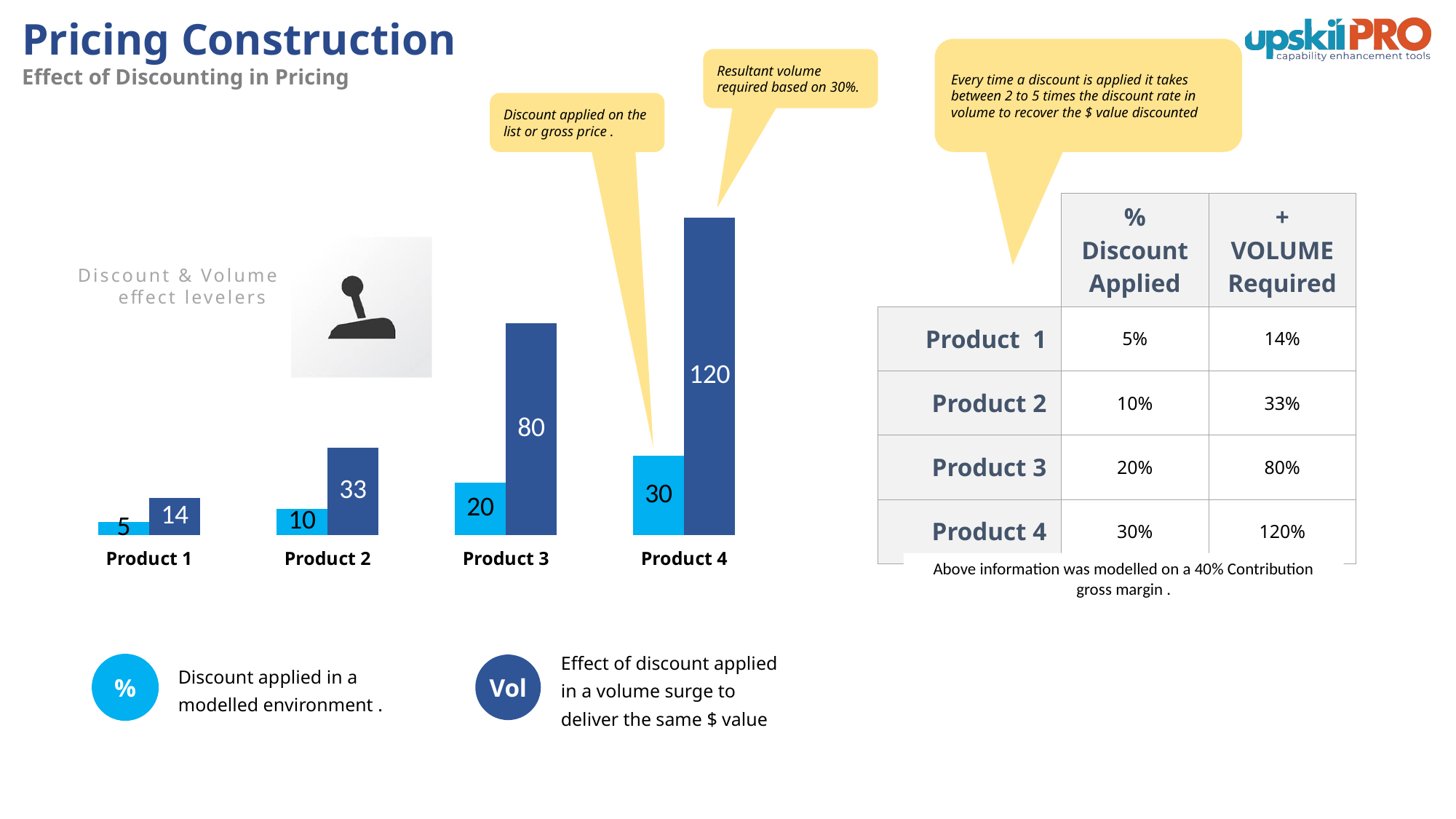
What colour are the discount bars in the chart? Light blue What is the discount value shown for Product 3 in the bar chart? 20 How many products are shown on the x axis of the bar chart? 4 Which product has the highest volume bar in the chart? Product 4 What is the volume value shown for Product 2 in the bar chart? 33 What kind of chart is used to show discount and volume by product? Bar chart What is the volume value shown for Product 4 in the bar chart? 120 Which is larger: the volume value for Product 2 or the discount value for Product 4? Volume value for Product 2 What is the difference between the volume value and the discount value for Product 3? 60 What is the difference between the volume values for Product 4 and Product 2? 87 Which product has the lowest discount bar in the chart? Product 1 Do the volume values rise or fall from Product 1 to Product 4? Rise